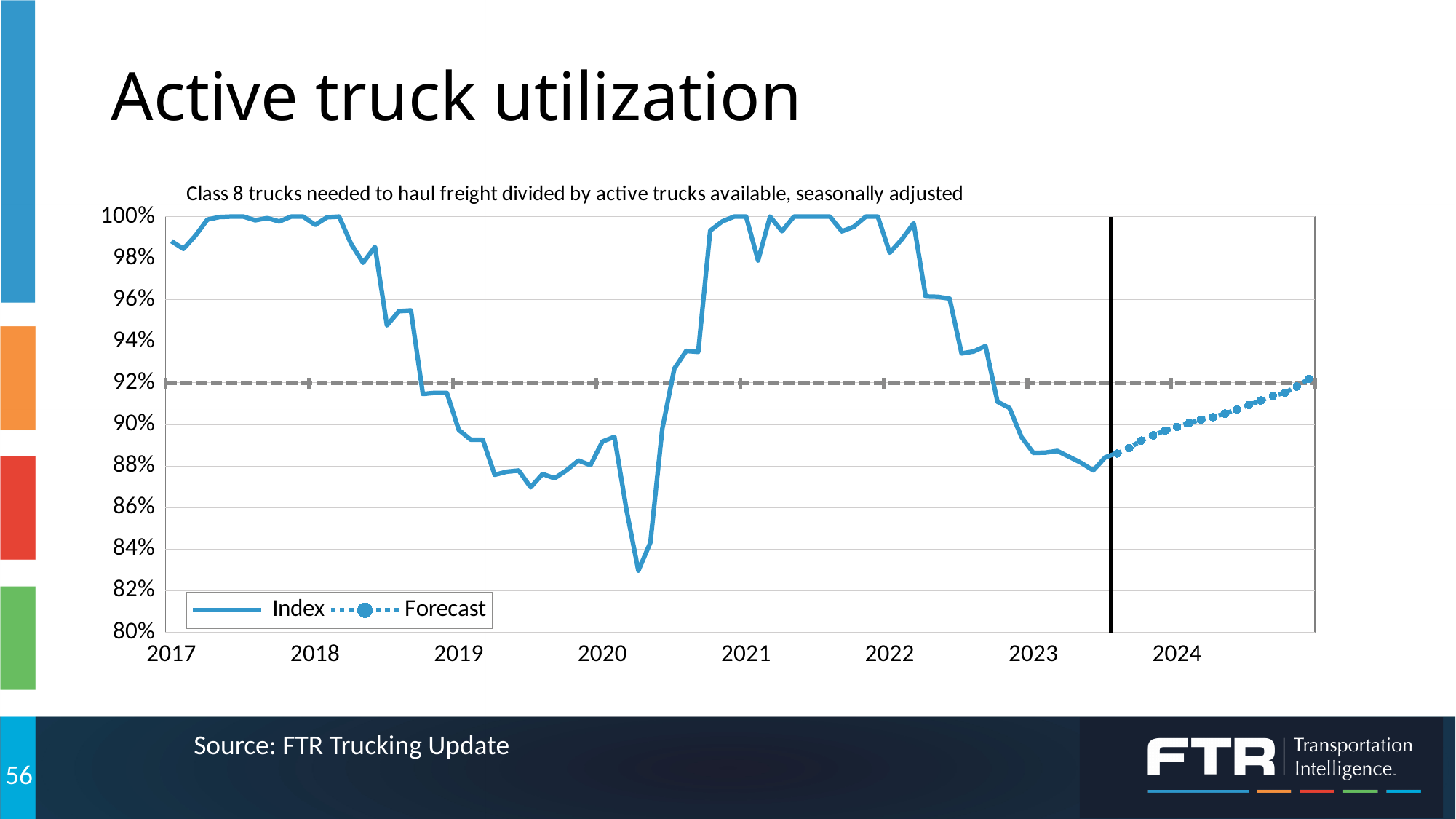
What kind of chart is shown on the slide? line chart What is the title of the chart on the slide? Class 8 trucks needed to haul freight divided by active trucks available, seasonally adjusted Is the Index value at the start of 2023 greater or less than 90%? less What are the two series named in the legend? Index and Forecast How many series does the legend list? 2 Is the Index value at the start of 2017 greater or less than 96%? greater Which is larger, the Index value at the start of 2022 or at the start of 2023? start of 2022 Is the Index value at the start of 2021 greater or less than 98%? greater In which year does the Index line reach its lowest point? 2020 Does the Forecast series rise or fall across 2024? rise